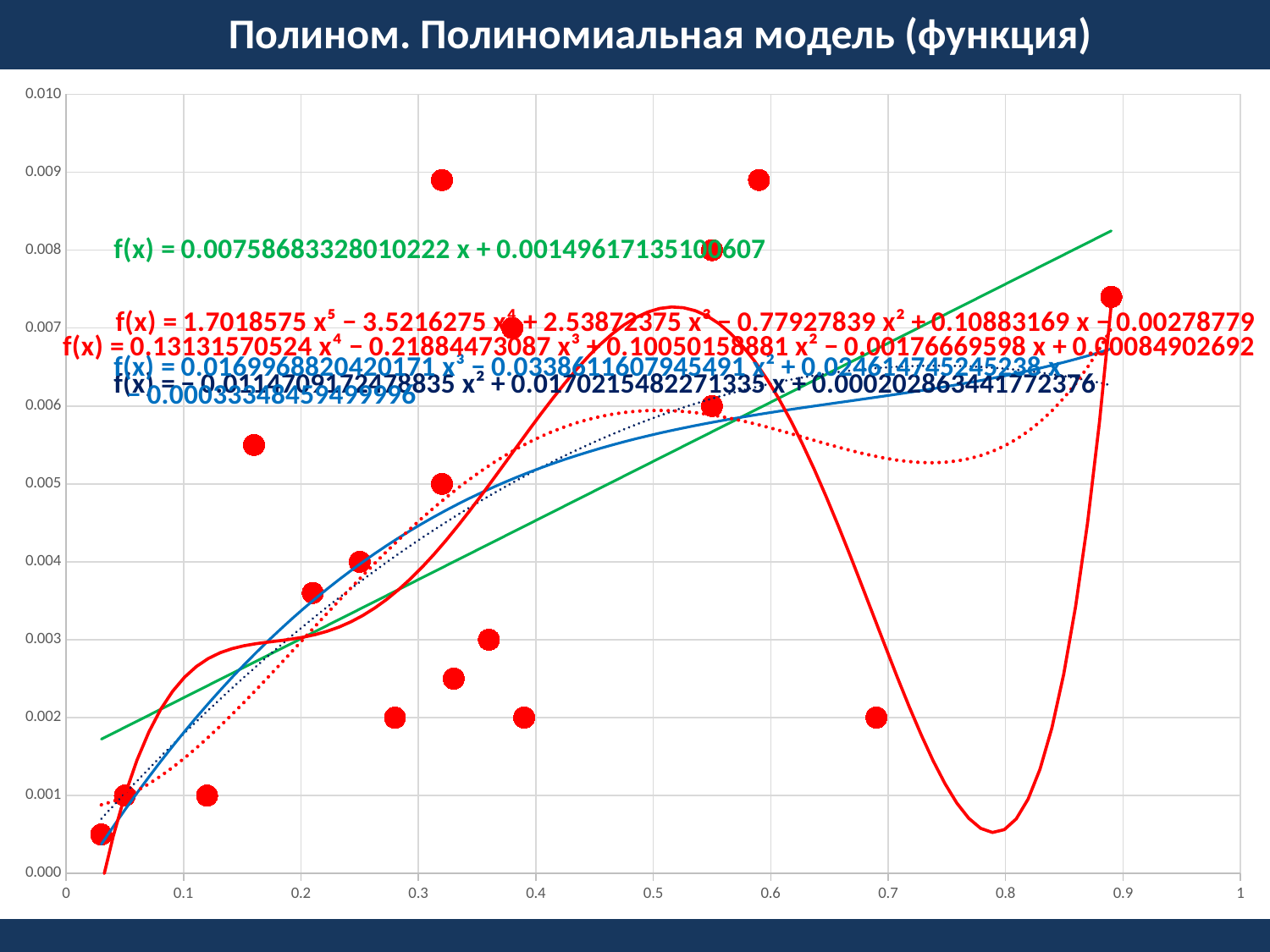
Does the green linear trendline rise or fall as x increases? rises Is the value of the data point at x ≈ 0.69 greater or less than 0.003? less Is the value of the data point at x ≈ 0.16 greater or less than 0.005? greater What kind of chart is shown on the slide? scatter chart What is the title of the slide containing the chart? Полином. Полиномиальная модель (функция) What is the maximum value shown on the y axis? 0.010 What is the highest polynomial degree among the trendline equations shown on the chart? 5 Which data point has the larger y value: the upper point at x ≈ 0.32 or the point at x ≈ 0.69? the upper point at x ≈ 0.32 What is the constant term in the quadratic trendline equation f(x) = −0.0114709172478835 x² + 0.0170215482271335 x + ...? 0.000202863441772376 What is the coefficient of x⁵ in the fifth-degree polynomial trendline equation? 1.7018575 Is the value of the data point at x ≈ 0.89 greater or less than 0.007? greater What is the slope coefficient of x in the green linear trendline equation f(x) = ... x + 0.00149617135100607? 0.00758683328010222